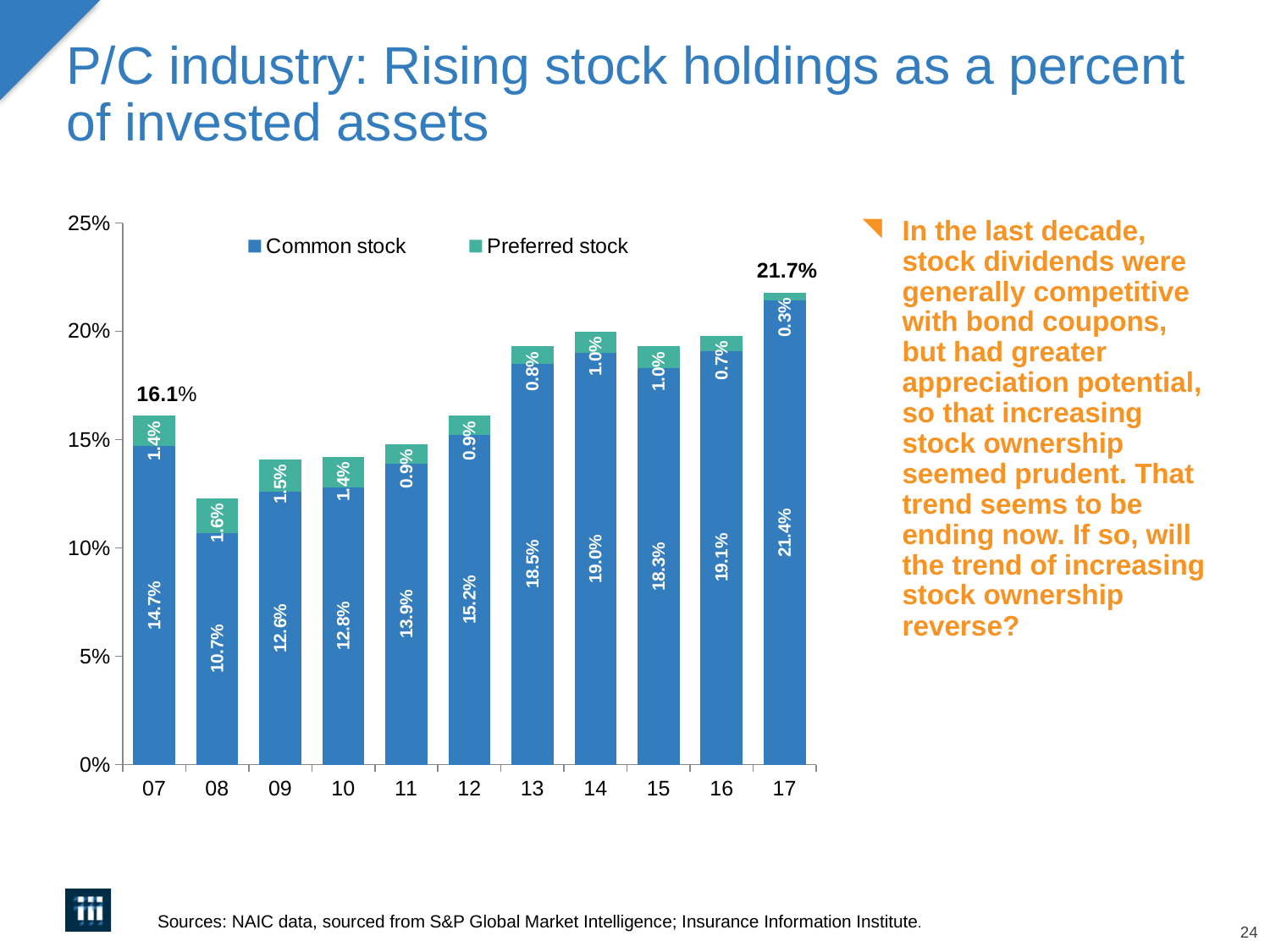
What is the total stacked value for 07? 16.1% Which year has the lowest Preferred stock value? 17 How many series does the legend list? 2 How many years are shown on the x axis? 11 What kind of chart is shown on the slide? stacked bar chart What is the difference between the Common stock values for 17 and 07? 6.7% What is the Common stock value for 13? 18.5% Which year has the highest Common stock value? 17 Which year has the lowest Common stock value? 08 Which year has the larger Common stock value, 14 or 15? 14 What is the Preferred stock value for 08? 1.6% Is the total stacked value for 13 greater or less than 20%? less